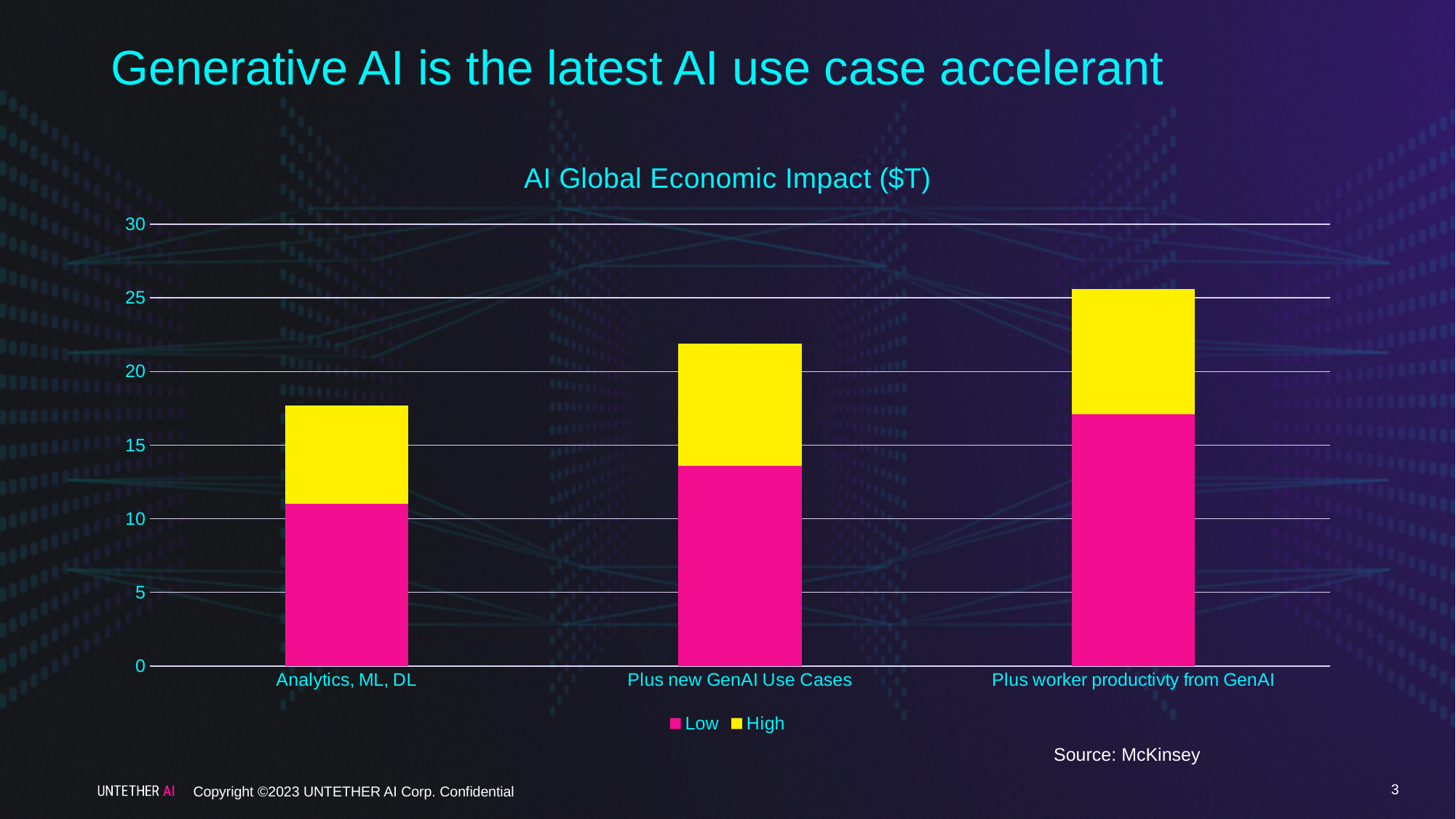
Is the total stacked bar for Analytics, ML, DL greater or less than 20? less What type of chart is shown on the slide? Stacked bar chart Is the total stacked bar for Plus new GenAI Use Cases greater or less than 20? greater Which is larger, the Low value for Plus new GenAI Use Cases or the Low value for Analytics, ML, DL? Plus new GenAI Use Cases How many categories are shown on the x axis? 3 Is the Low value for Plus worker productivty from GenAI greater or less than 15? greater How many series does the legend list? 2 Do the total bar heights rise or fall from left to right across the categories? Rise Which category has the tallest stacked bar? Plus worker productivty from GenAI Which category has the shortest stacked bar? Analytics, ML, DL What is the title of the chart? AI Global Economic Impact ($T)